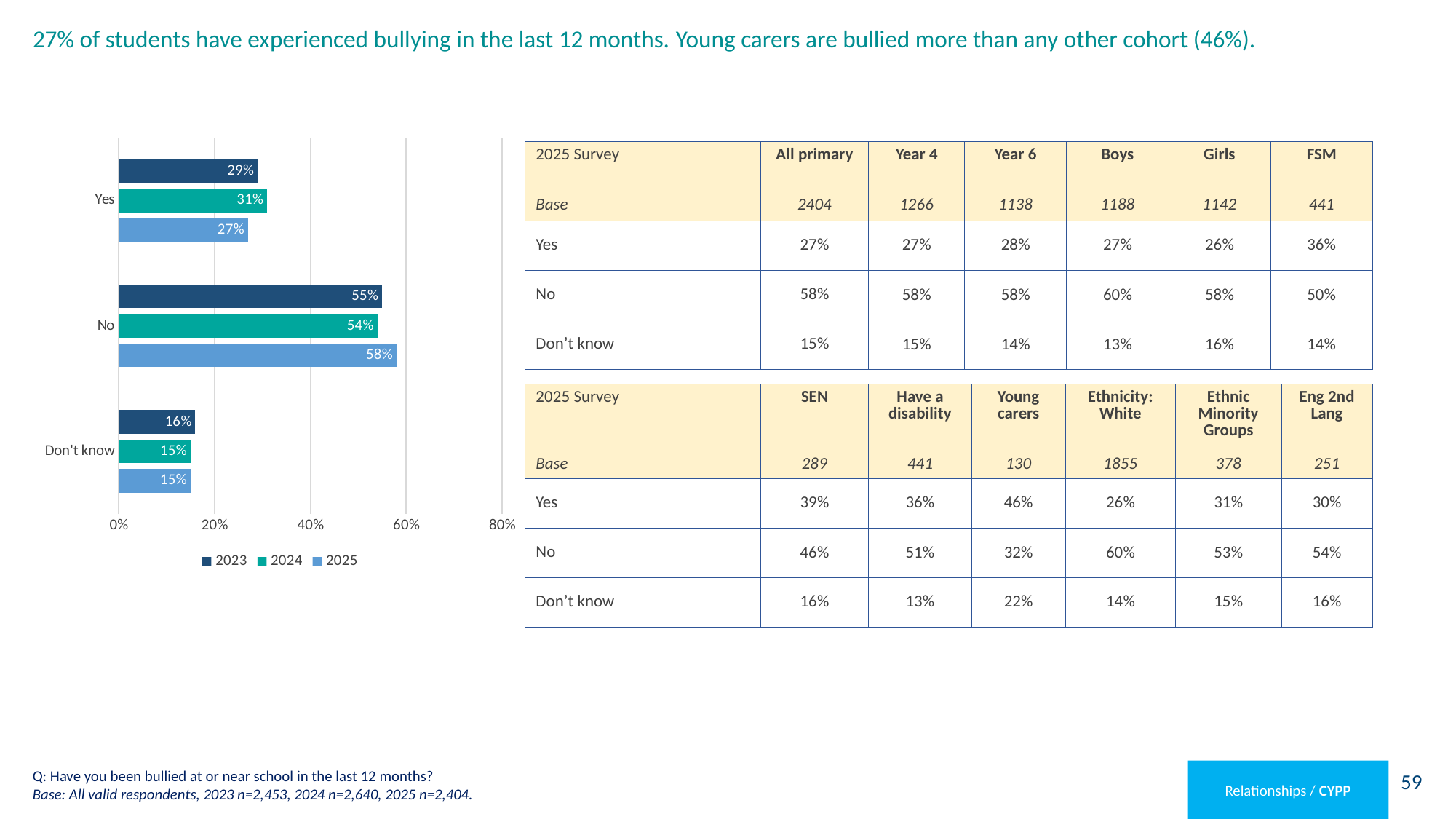
Which is larger in the chart: the 2023 value for 'Yes' or the 2025 value for 'Yes'? 2023 Is the 2025 value for 'No' in the chart greater or less than 40%? greater What is the difference between the 2024 and 2025 values for 'Yes' in the chart? 4% What is the 2025 value for 'Yes' in the chart? 27% What kind of chart is shown on the left of the slide? bar chart What is the 2024 value for 'Don't know' in the chart? 15% Which category has the lowest 2023 value in the chart? Don't know Which series in the chart legend is shown in the darkest blue? 2023 How many categories are shown on the chart's y axis? 3 Which category has the highest 2025 value in the chart? No What is the 2023 value for 'No' in the chart? 55% How many series does the chart legend list? 3